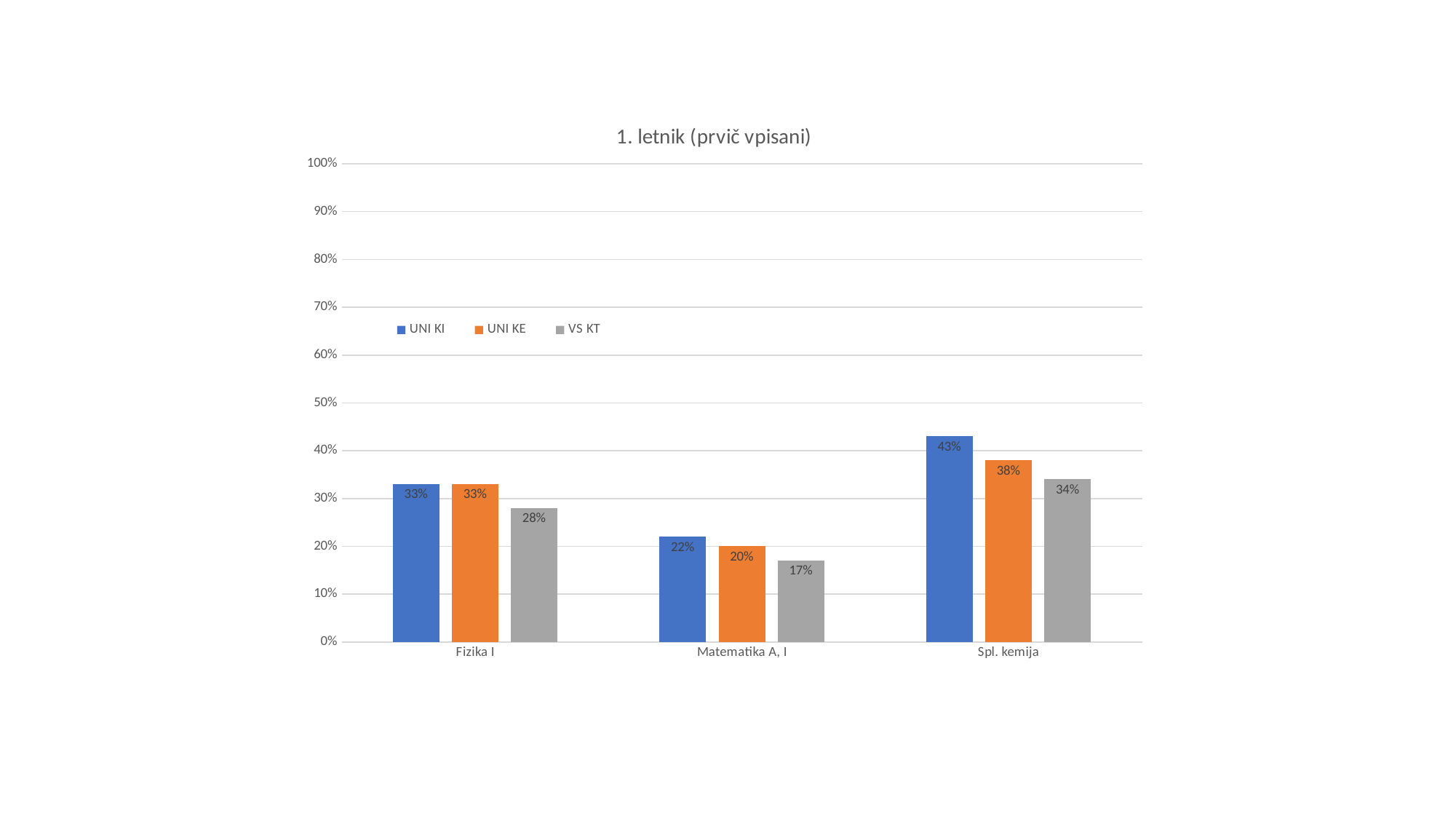
Which category has the highest value for UNI KI? Spl. kemija What is the value for UNI KI in the Fizika I category? 33% What is the value for VS KT in the Matematika A, I category? 17% What is the difference between the UNI KI and VS KT values in the Spl. kemija category? 9% Which is larger in the Matematika A, I category: UNI KI or UNI KE? UNI KI How many categories are shown on the x axis? 3 What is the value for UNI KE in the Spl. kemija category? 38% Is the value for UNI KI in Spl. kemija greater or less than 40%? greater What kind of chart is shown on the slide? bar chart How many series does the legend list? 3 Which category has the lowest value for VS KT? Matematika A, I What is the title of the chart? 1. letnik (prvič vpisani)